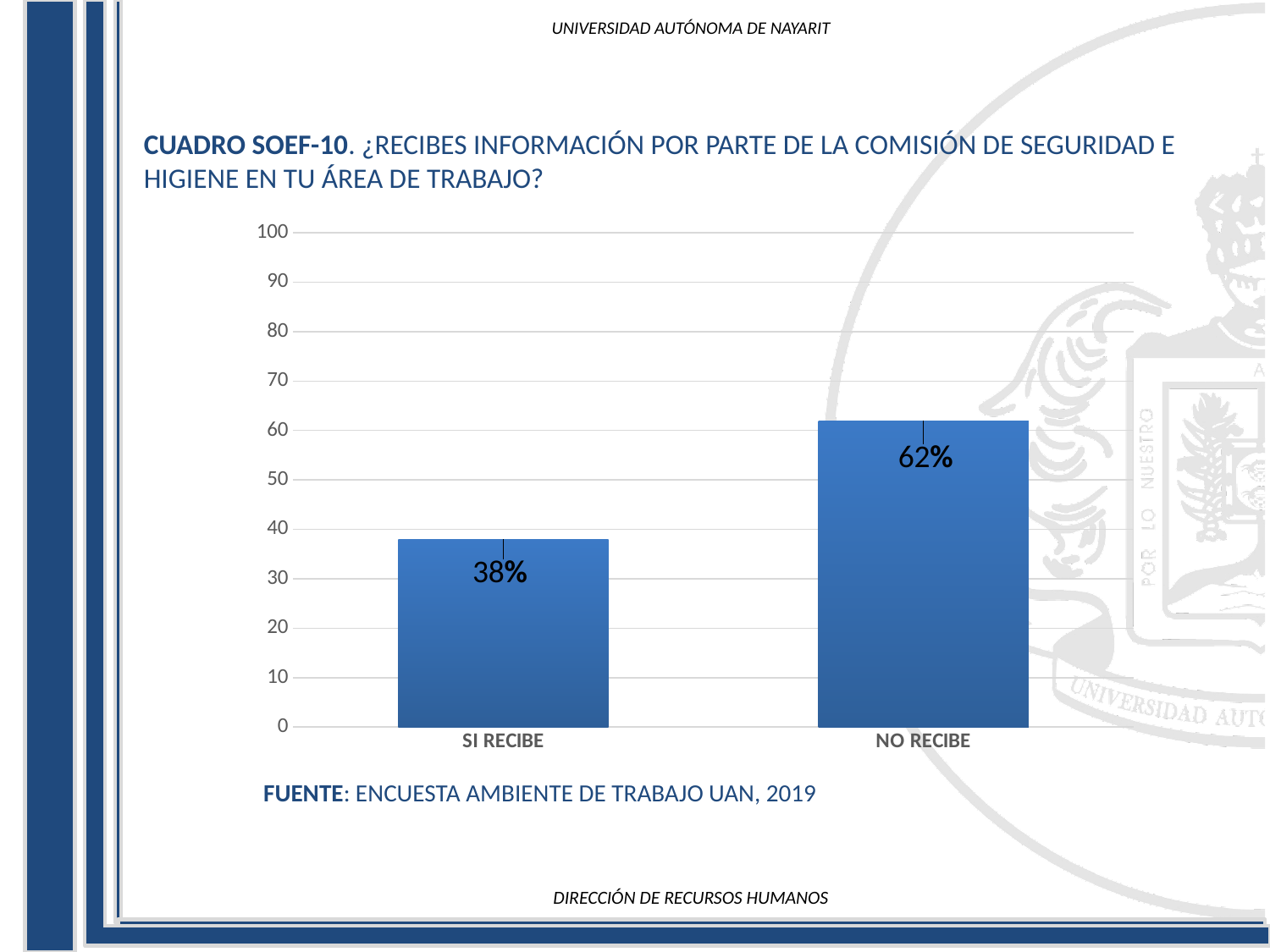
Which is larger, the value for SI RECIBE or the value for NO RECIBE? NO RECIBE What source is cited below the chart? ENCUESTA AMBIENTE DE TRABAJO UAN, 2019 Which category has the lowest value? SI RECIBE What kind of chart is shown on the slide? bar chart How many categories are shown on the x axis? 2 Is the value for NO RECIBE greater or less than 50? greater What is the difference between the values for NO RECIBE and SI RECIBE? 24% What is the value for SI RECIBE? 38% Is the value for SI RECIBE greater or less than 40? less What is the value for NO RECIBE? 62% What is the total of the two bar values? 100% Which category has the highest value? NO RECIBE